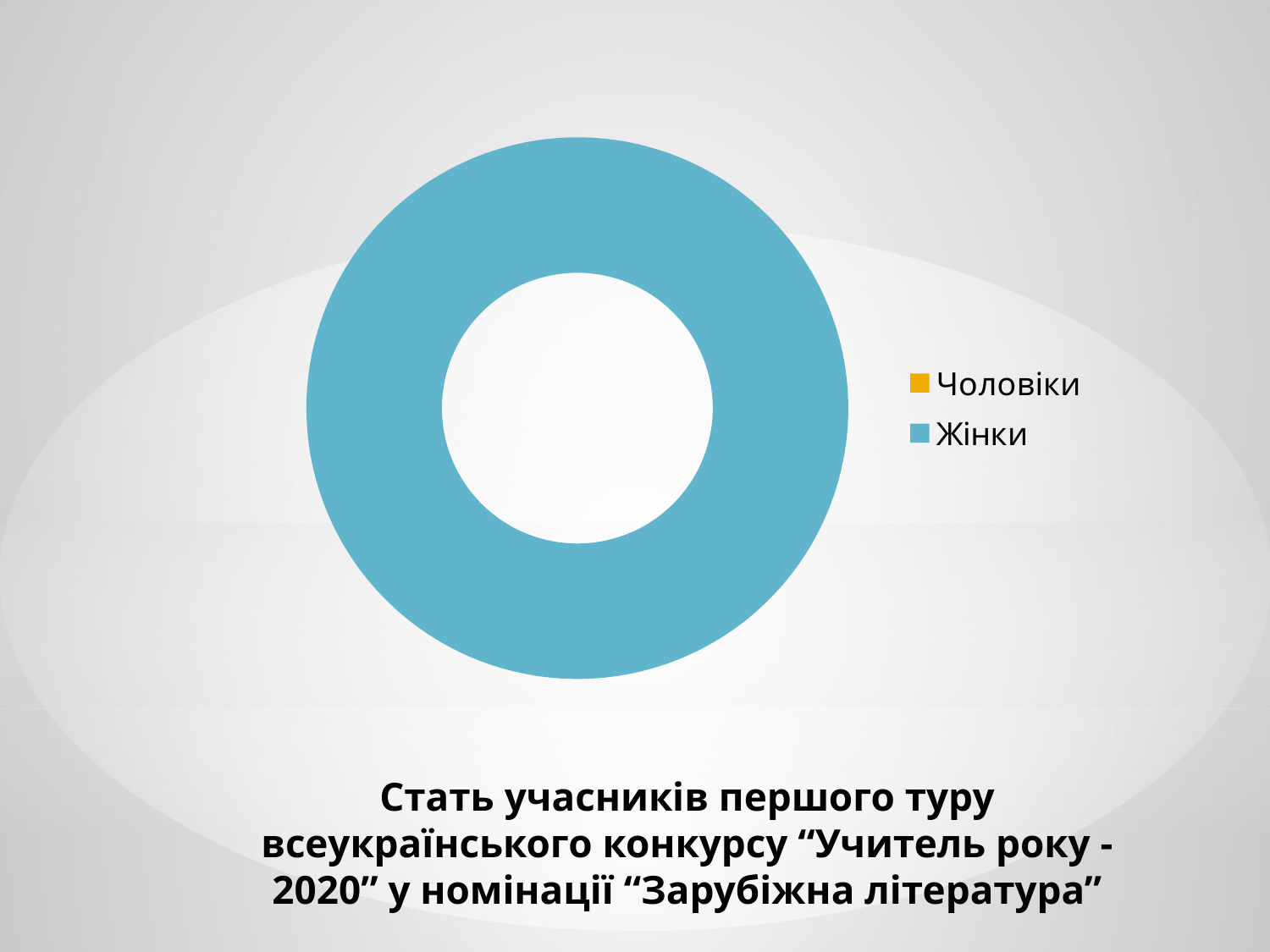
Which category has the smallest share of the doughnut chart? Чоловіки What colour represents Чоловіки in the legend of the chart? Orange Is the share of Жінки in the chart greater or less than 50%? greater How many categories does the legend of the chart list? 2 What colour represents Жінки in the chart? Blue Which category has the largest share of the doughnut chart? Жінки What kind of chart is shown on the slide? Doughnut chart Which category has a larger share of the chart, Чоловіки or Жінки? Жінки Is the share of Чоловіки in the chart greater or less than 50%? less